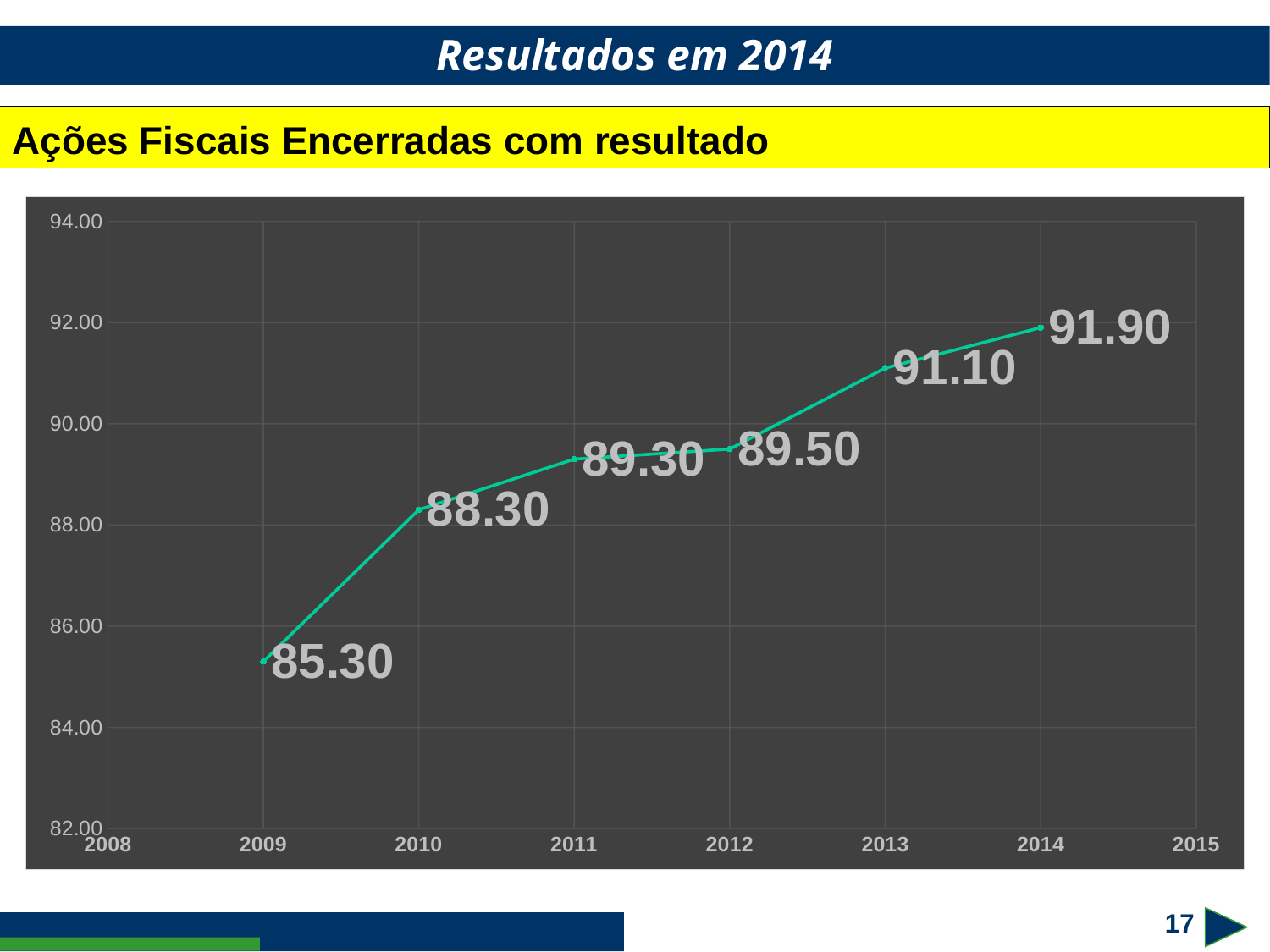
Do the values rise or fall from 2009 to 2014? rise Which is larger, the value for 2013 or the value for 2011? 2013 What is the value for 2014? 91.90 What is the difference between the values for 2010 and 2009? 3.00 What is the value for 2012? 89.50 What is the difference between the values for 2014 and 2009? 6.60 Is the value for 2010 greater or less than 90.00? less How many data points are plotted on the chart? 6 What is the value for 2009? 85.30 What kind of chart is shown on the slide? line chart Which year has the highest value? 2014 Which year has the lowest value? 2009